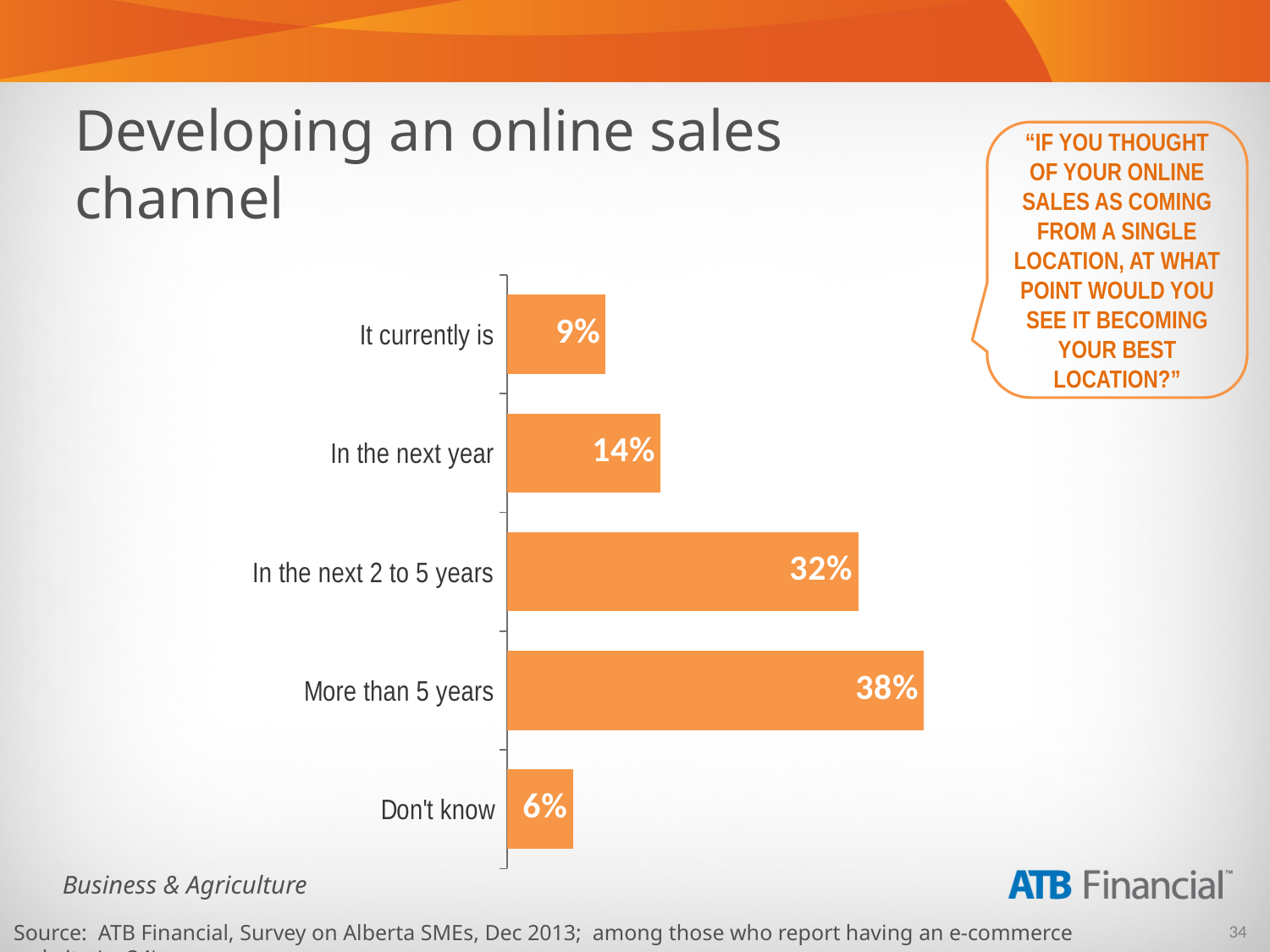
What is the title of the slide containing the chart? Developing an online sales channel Which category has the lowest value? Don't know What is the difference between the values for "In the next year" and "It currently is"? 5% What is the value for "In the next year"? 14% What percentage of respondents answered "Don't know"? 6% How many categories are shown in the chart? 5 What percentage of respondents said their online sales channel currently is their best location? 9% Which category has the highest value? More than 5 years Which is larger, the value for "In the next year" or the value for "It currently is"? In the next year What is the difference between the values for "More than 5 years" and "In the next 2 to 5 years"? 6% What is the value for "In the next 2 to 5 years"? 32% What kind of chart is shown on the slide? Bar chart